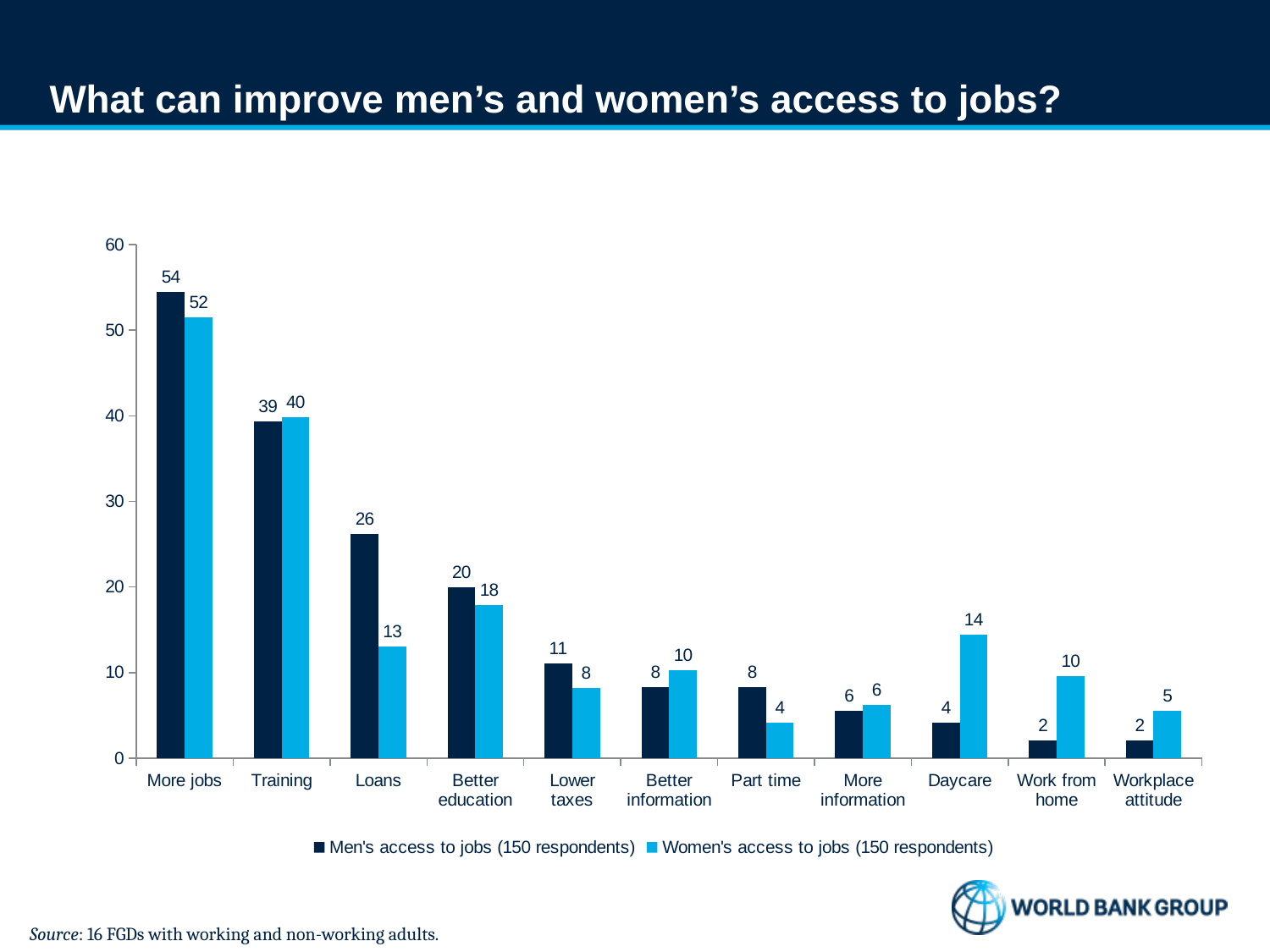
What is the title of the slide? What can improve men's and women's access to jobs? What kind of chart is shown on the slide? Bar chart How many series does the legend list? 2 What is the value for Women's access to jobs for Loans? 13 What is the difference between the Women's and Men's values for Daycare? 10 Which category has the highest value for Women's access to jobs? More jobs What is the difference between the Men's and Women's values for Loans? 13 Which category has the lowest value for Women's access to jobs? Part time How many categories are shown on the x axis? 11 What is the value for Women's access to jobs for Daycare? 14 For Work from home, which series has the larger value, Men's access to jobs or Women's access to jobs? Women's access to jobs What is the value for Men's access to jobs for More jobs? 54